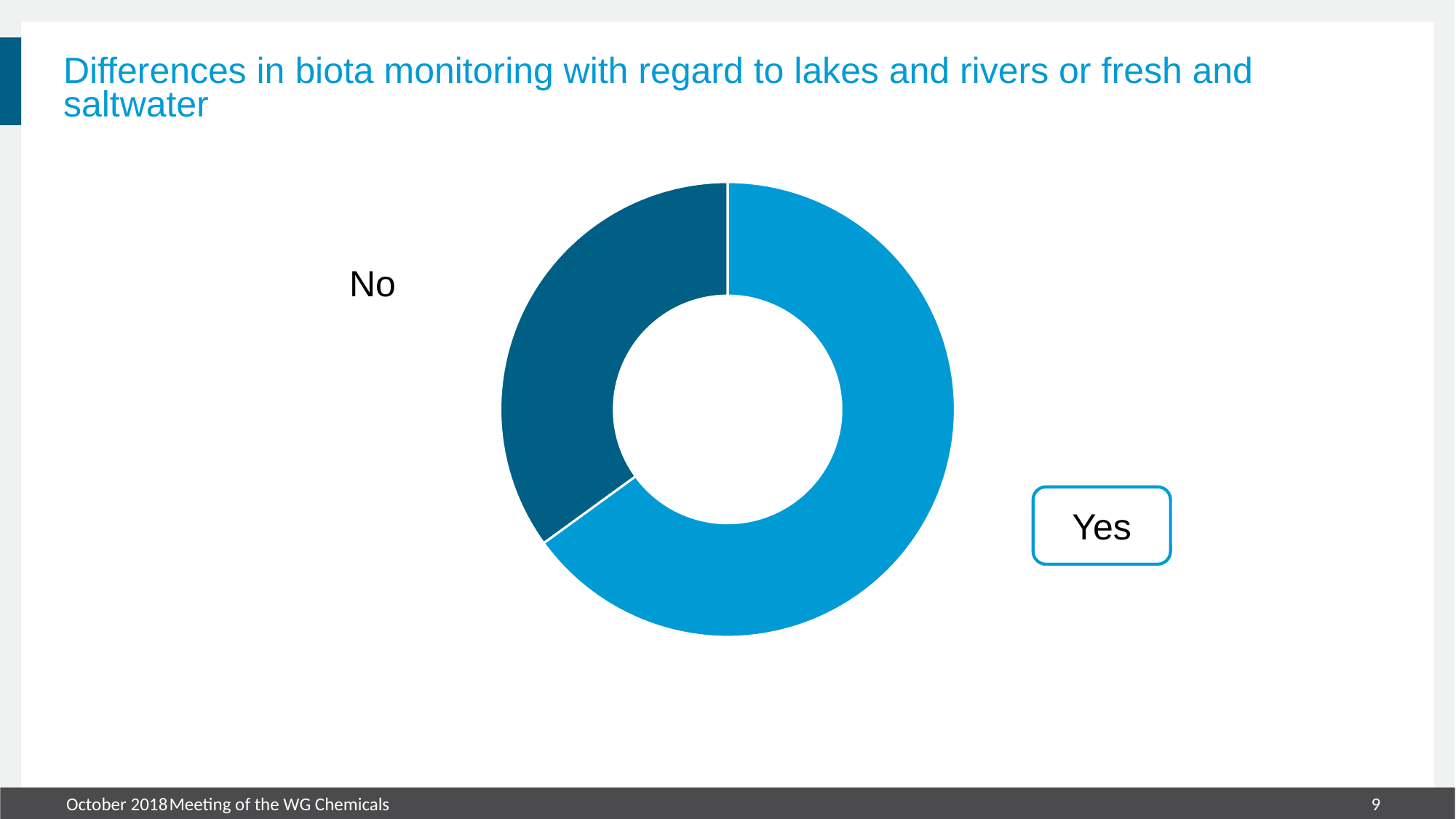
What colour is the slice for Yes? Light blue Is the share for No greater or less than half of the chart? less Which category has the largest share of the chart? Yes Is the share for Yes greater or less than half of the chart? greater What kind of chart is shown on the slide? Doughnut (pie) chart Which category has the smallest share of the chart? No Which is larger, the share for Yes or the share for No? Yes What is the title of the slide containing the chart? Differences in biota monitoring with regard to lakes and rivers or fresh and saltwater How many categories does the chart show? 2